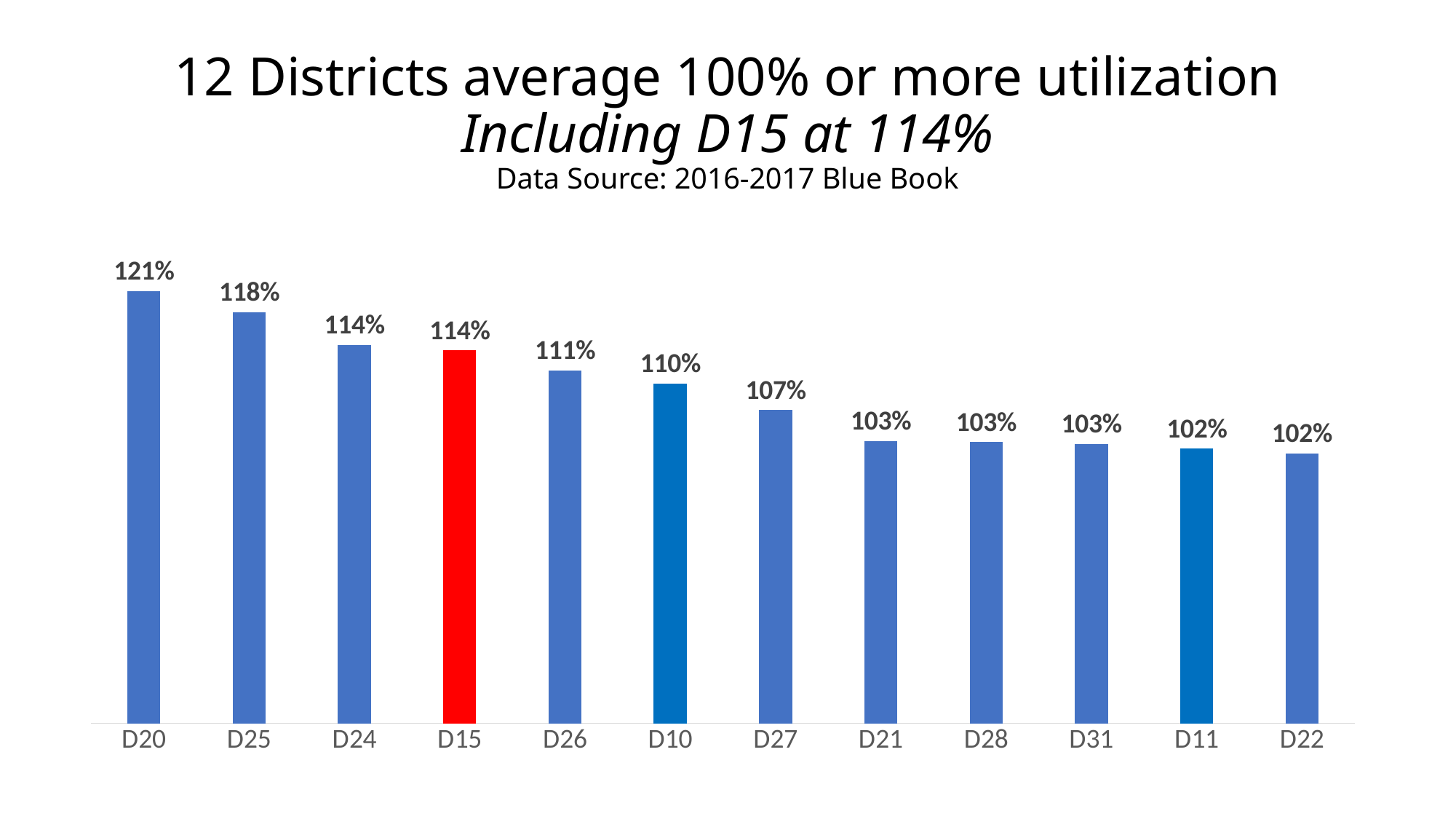
Do the utilization values rise or fall from left to right across the districts? Fall Which has a higher utilization value, D25 or D24? D25 What is the difference between the utilization values for D15 and D22? 12% Which has a higher utilization value, D26 or D21? D26 Which district has the highest utilization? D20 What is the utilization value for D27? 107% What is the utilization value for D15? 114% What is the utilization value for D10? 110% What kind of chart is shown on the slide? Bar chart Which district's bar is coloured red? D15 What is the difference between the utilization values for D20 and D25? 3% How many districts are shown in the chart? 12